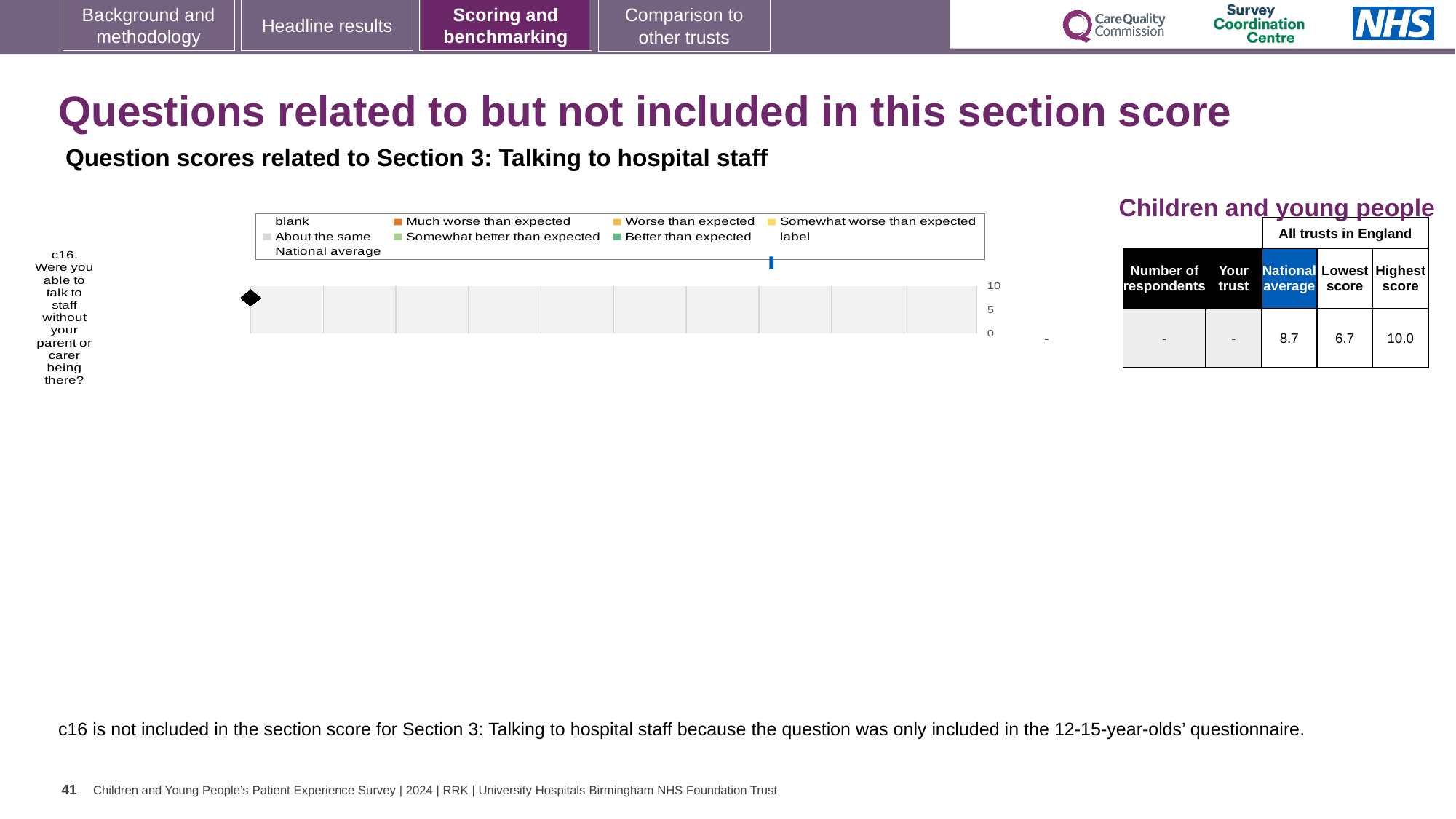
Which question is shown on the chart's category axis? c16. Were you able to talk to staff without your parent or carer being there? What is the maximum value shown on the chart's value axis? 10 What kind of chart is shown on the slide? bar chart In the table next to the chart, what is the national average score for c16? 8.7 In the table next to the chart, what is the lowest score across all trusts in England for c16? 6.7 In the table next to the chart, what is the difference between the highest score and the lowest score for c16? 3.3 In the table next to the chart, what is shown for the trust's own score for c16? - In the table next to the chart, what is the highest score across all trusts in England for c16? 10.0 In the table next to the chart, which is larger for c16: the national average or the lowest score? national average How many question categories are plotted on the chart? 1